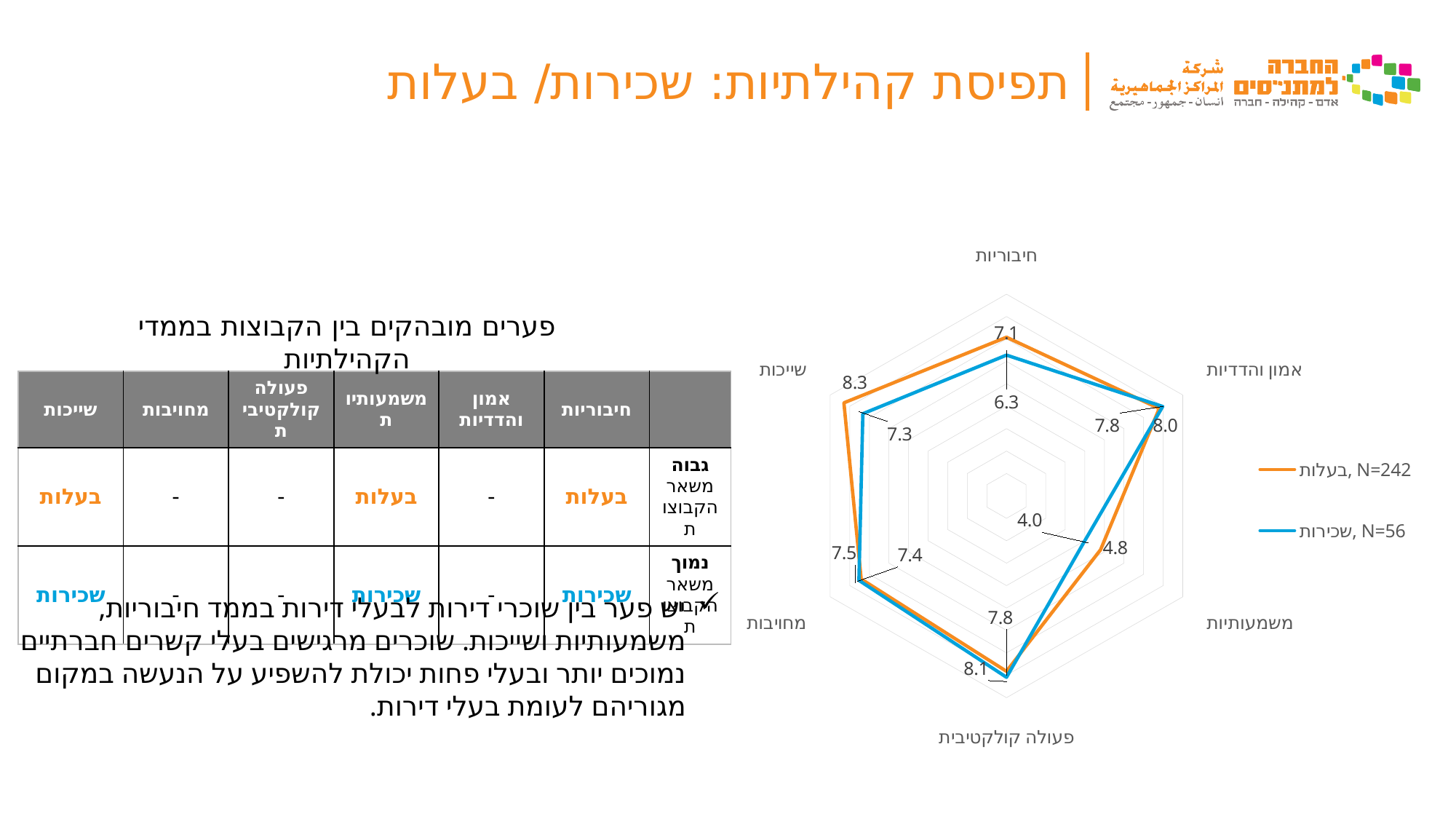
On which axis does the שכירות series have its lowest value? משמעותיות How many series does the chart legend list? 2 What is the value for שכירות on the חיבוריות axis? 6.3 What is the difference between בעלות and שכירות on the שייכות axis? 1.0 What is the value for שכירות on the משמעותיות axis? 4.0 What sample size (N) does the legend give for the שכירות series? N=56 What is the value for בעלות on the חיבוריות axis? 7.1 How many axes (categories) does the radar chart have? 6 What is the value for בעלות on the שייכות axis? 8.3 Which series has the larger value on the פעולה קולקטיבית axis, בעלות or שכירות? שכירות What kind of chart is shown on the slide? Radar chart On which axis does the בעלות series reach its highest value? שייכות